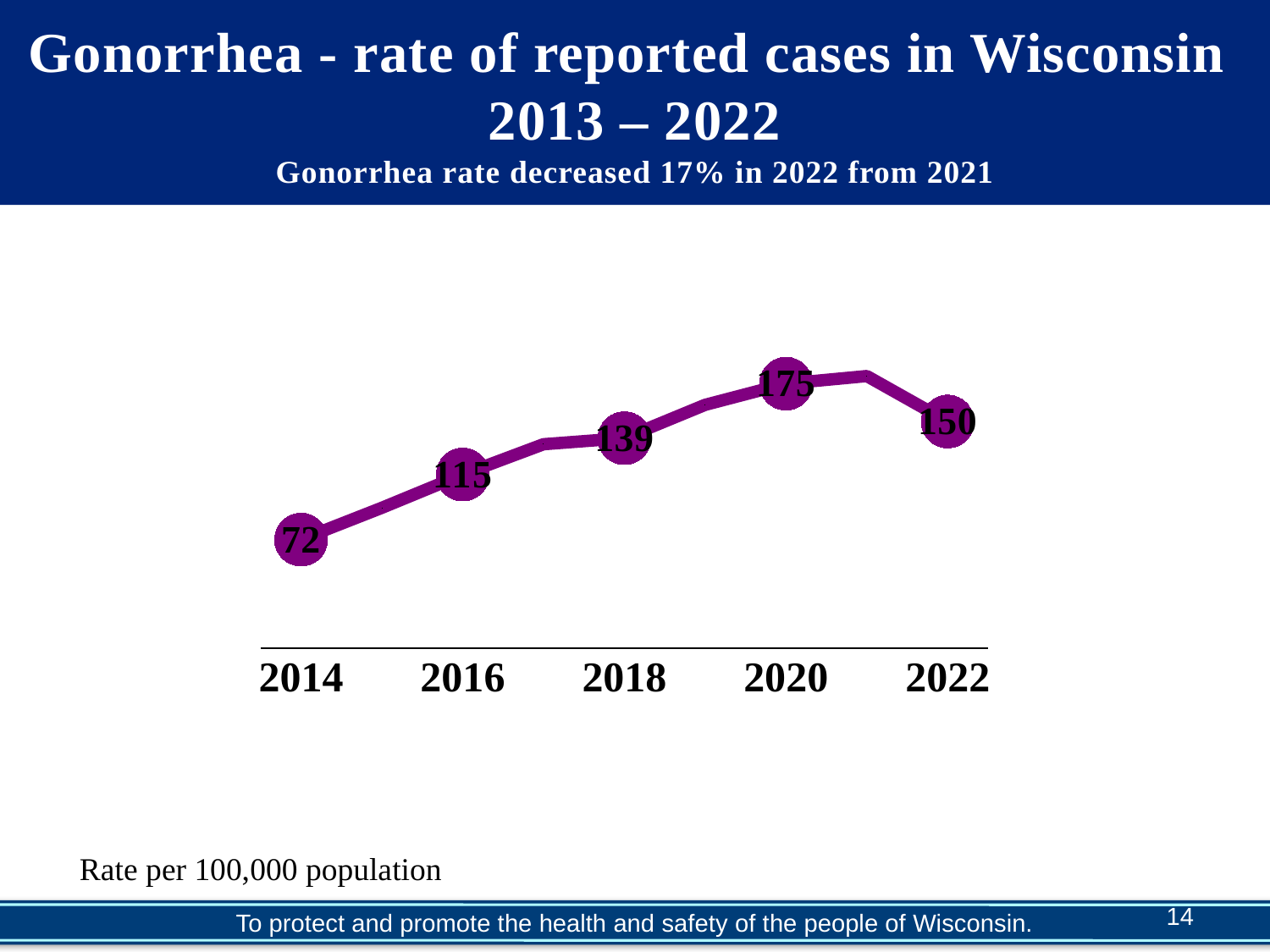
What is the gonorrhea rate shown for 2014? 72 Which labeled year has the lowest gonorrhea rate? 2014 What is the gonorrhea rate shown for 2018? 139 What is the difference between the 2016 and 2014 gonorrhea rates? 43 By how much did the gonorrhea rate fall from 2020 to 2022? 25 Which labeled year has the highest gonorrhea rate? 2020 What is the gonorrhea rate shown for 2020? 175 What is the gonorrhea rate shown for 2016? 115 Do the gonorrhea rates rise or fall from 2014 to 2020? rise What kind of chart is shown on the slide? line chart What is the gonorrhea rate shown for 2022? 150 Which year has a higher gonorrhea rate, 2018 or 2022? 2022